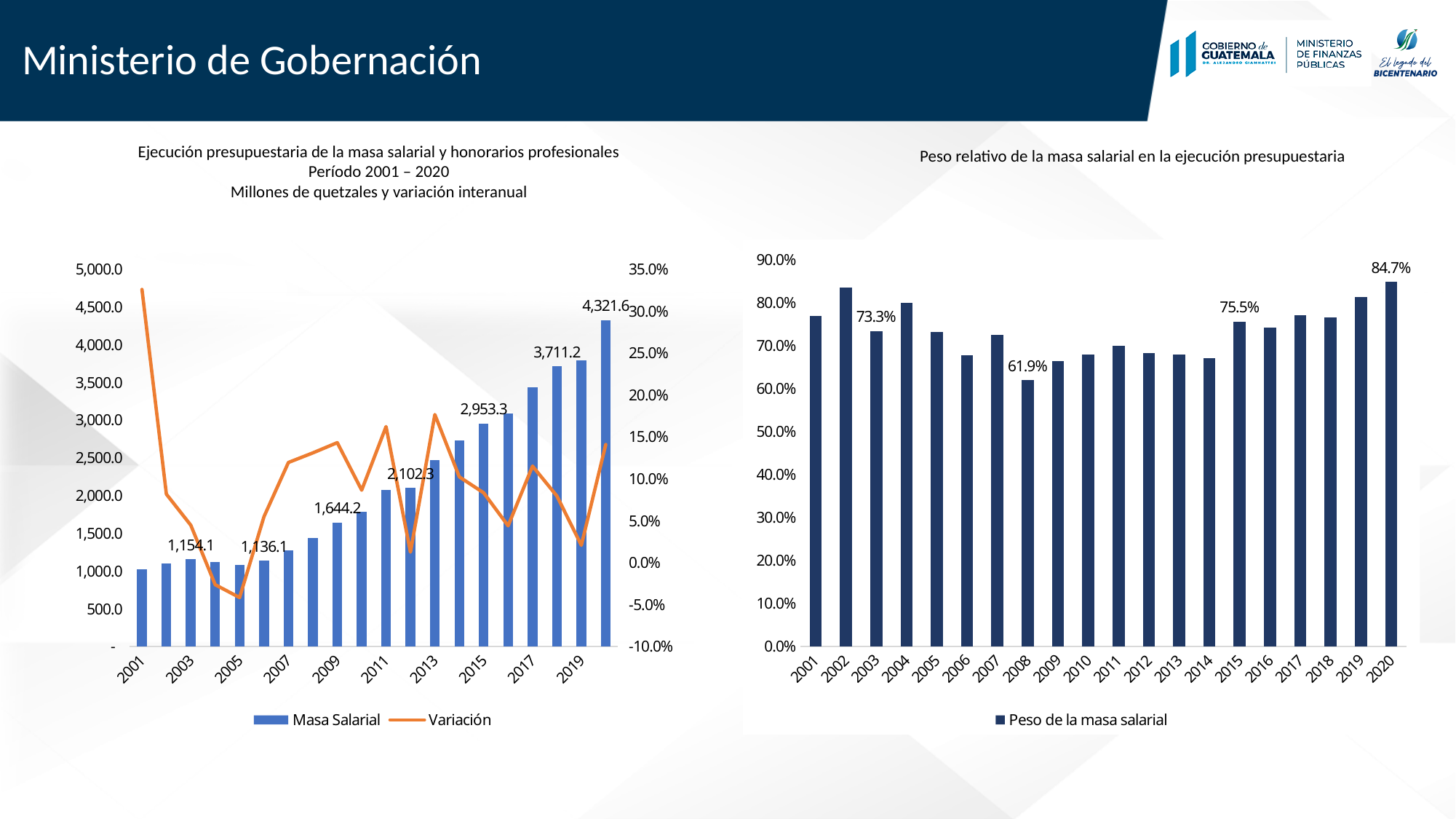
In the left chart 'Ejecución presupuestaria de la masa salarial y honorarios profesionales', what is the difference between the Masa Salarial values for 2020 and 2018? 610.4 In the chart 'Peso relativo de la masa salarial en la ejecución presupuestaria', what is the difference between the 2020 value and the 2008 value? 22.8 percentage points In the chart 'Peso relativo de la masa salarial en la ejecución presupuestaria', which year has the highest value? 2020 In the chart 'Peso relativo de la masa salarial en la ejecución presupuestaria', what is the value for 2008? 61.9% In the left chart 'Ejecución presupuestaria de la masa salarial y honorarios profesionales', what is the Masa Salarial value for 2015? 2,953.3 In the chart 'Peso relativo de la masa salarial en la ejecución presupuestaria', what is the value for 2020? 84.7% In the chart 'Peso relativo de la masa salarial en la ejecución presupuestaria', which year has the lowest value? 2008 In the left chart 'Ejecución presupuestaria de la masa salarial y honorarios profesionales', what is the Masa Salarial value for 2020? 4,321.6 In the chart 'Peso relativo de la masa salarial en la ejecución presupuestaria', how many years are shown on the x axis? 20 In the left chart 'Ejecución presupuestaria de la masa salarial y honorarios profesionales', how many series does the legend list? 2 In the chart 'Peso relativo de la masa salarial en la ejecución presupuestaria', which is larger, the value for 2003 or the value for 2015? 2015 In the left chart 'Ejecución presupuestaria de la masa salarial y honorarios profesionales', is the Masa Salarial value for 2001 greater or less than 1,500.0? less